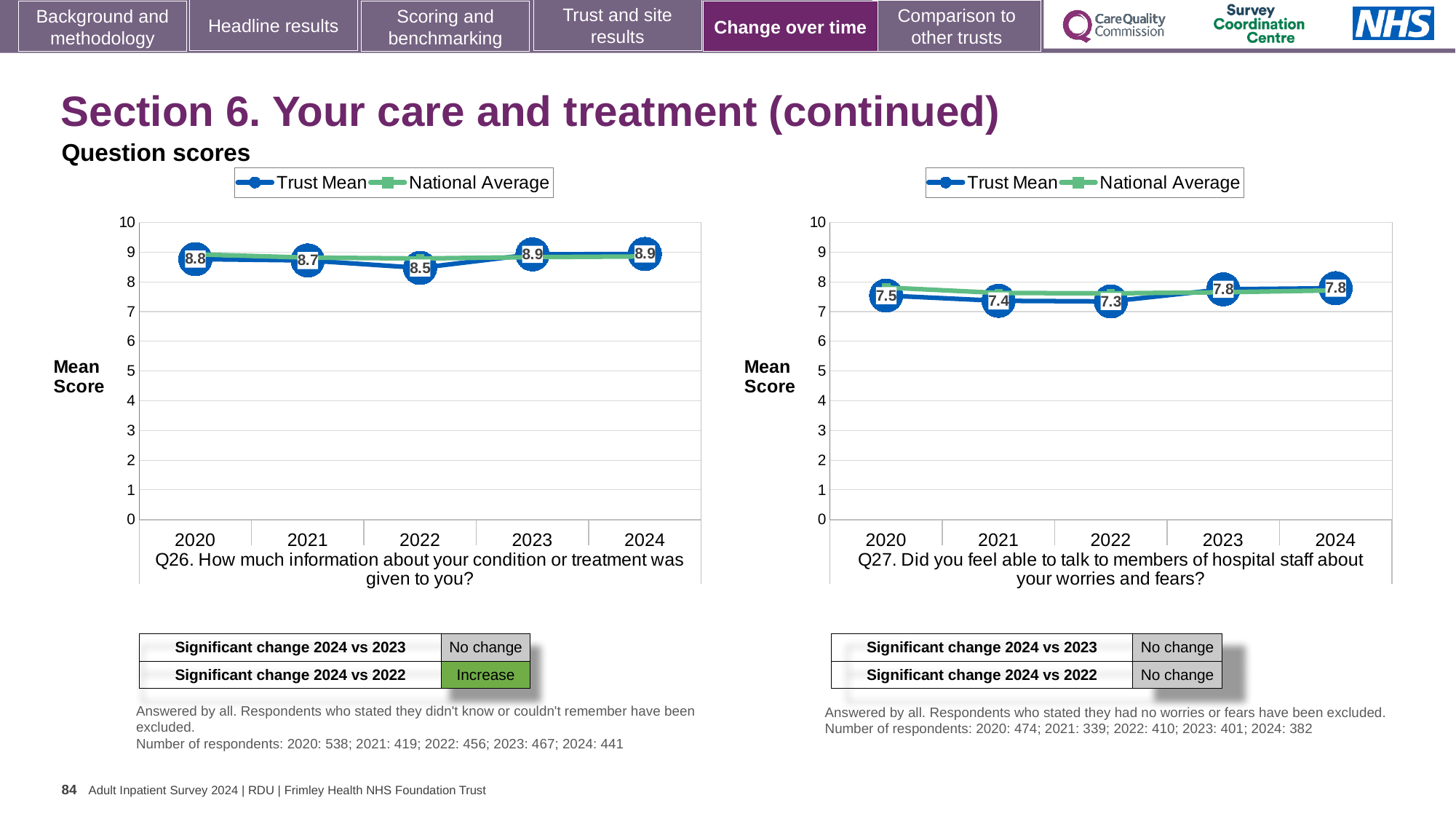
How many years are plotted on the x axis of the Q26 chart (left)? 5 In the Q26 chart (left), what is the difference between the Trust Mean scores for 2024 and 2022? 0.4 How many series does the legend of the Q27 chart (right) list? 2 In the Q27 chart (right), which year has the lowest Trust Mean score? 2022 In the Q26 chart (left), which year has the lowest Trust Mean score? 2022 In the Q27 chart (right), what is the Trust Mean score for 2020? 7.5 In the Q27 chart (right), does the Trust Mean score rise or fall from 2022 to 2024? Rise In the Q26 chart (left), what is the Trust Mean score for 2022? 8.5 In the Q27 chart (right), is the National Average for 2022 greater or less than 8? less What kind of chart is used for Q27 (right)? Line chart In the Q27 chart (right), what is the difference between the Trust Mean scores for 2023 and 2020? 0.3 In the Q26 chart (left), is the Trust Mean score higher in 2020 or in 2021? 2020